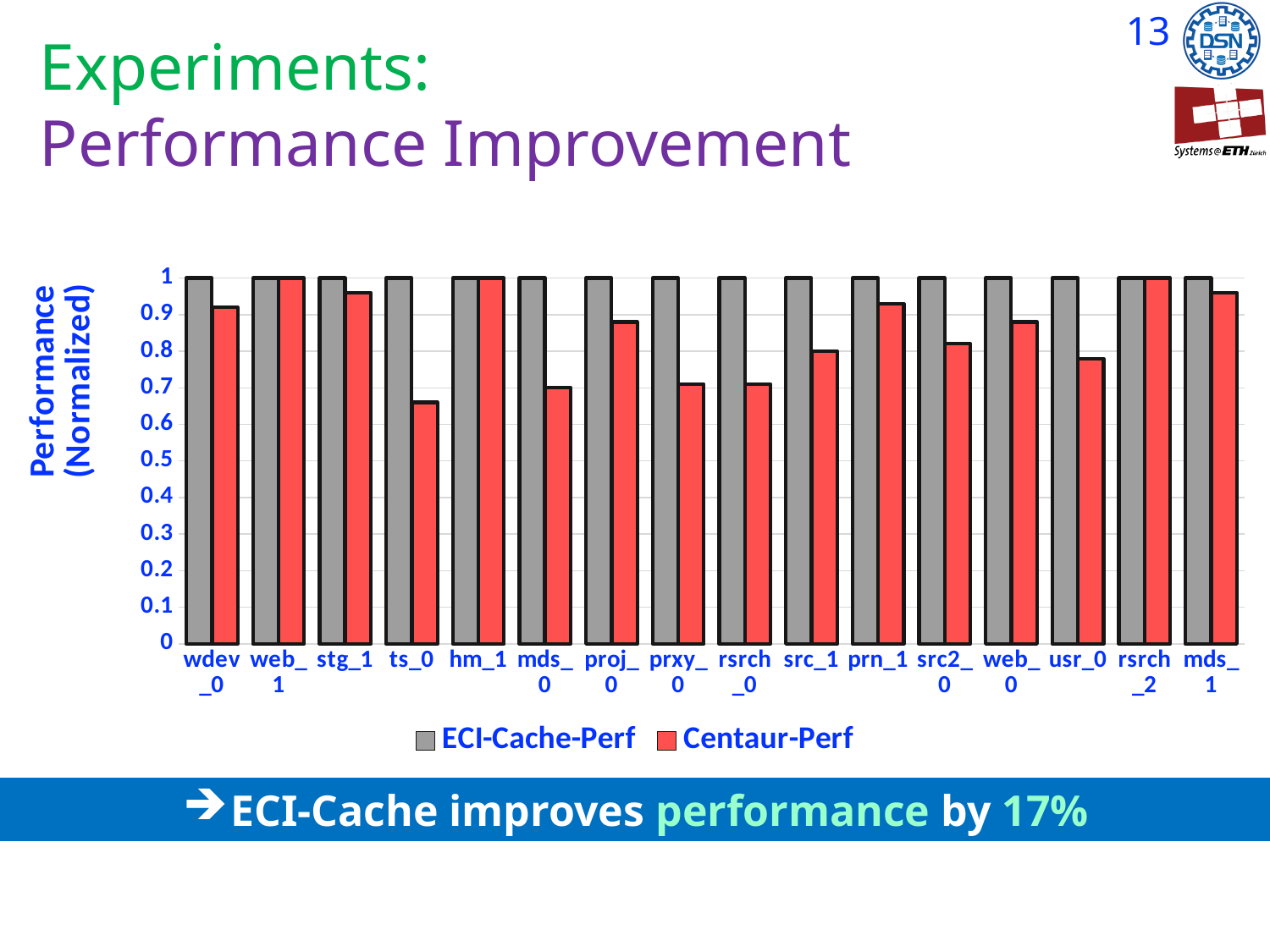
How many series does the legend list? 2 Is the Centaur-Perf value for usr_0 greater or less than 0.8? less Which has the larger Centaur-Perf value, ts_0 or usr_0? usr_0 Which is larger for proj_0, the ECI-Cache-Perf value or the Centaur-Perf value? ECI-Cache-Perf What kind of chart is shown on the slide? bar chart How many workload categories are shown on the x axis? 16 What is the Centaur-Perf value for hm_1? 1 What is the ECI-Cache-Perf value for ts_0? 1 Which category has the lowest Centaur-Perf value? ts_0 Is the Centaur-Perf value for ts_0 greater or less than 0.7? less Is the Centaur-Perf value for wdev_0 greater or less than 0.9? greater What is the label of the y axis? Performance (Normalized)